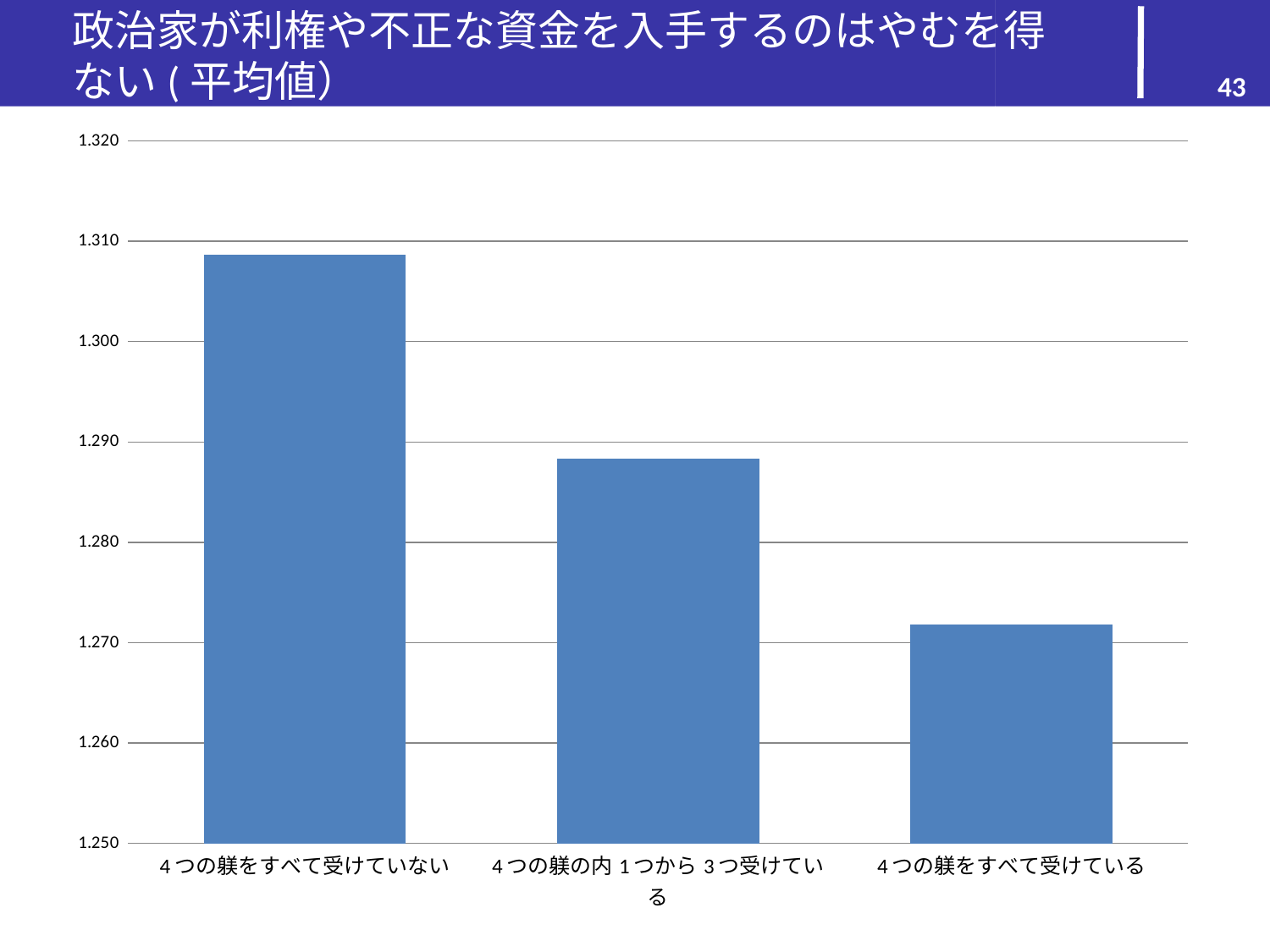
Do the values rise or fall from left to right across the categories? fall Which is larger, the value for 4つの躾をすべて受けていない or the value for 4つの躾の内1つから3つ受けている? 4つの躾をすべて受けていない Which category has the highest value? 4つの躾をすべて受けていない Is the value for 4つの躾をすべて受けている greater or less than 1.260? greater How many categories are plotted in the chart? 3 Is the value for 4つの躾の内1つから3つ受けている greater or less than 1.290? less What is the title of the chart on the slide? 政治家が利権や不正な資金を入手するのはやむを得ない(平均値) Which category has the lowest value? 4つの躾をすべて受けている Which is larger, the value for 4つの躾の内1つから3つ受けている or the value for 4つの躾をすべて受けている? 4つの躾の内1つから3つ受けている What kind of chart is shown on the slide? bar chart Is the value for 4つの躾をすべて受けている greater or less than 1.280? less